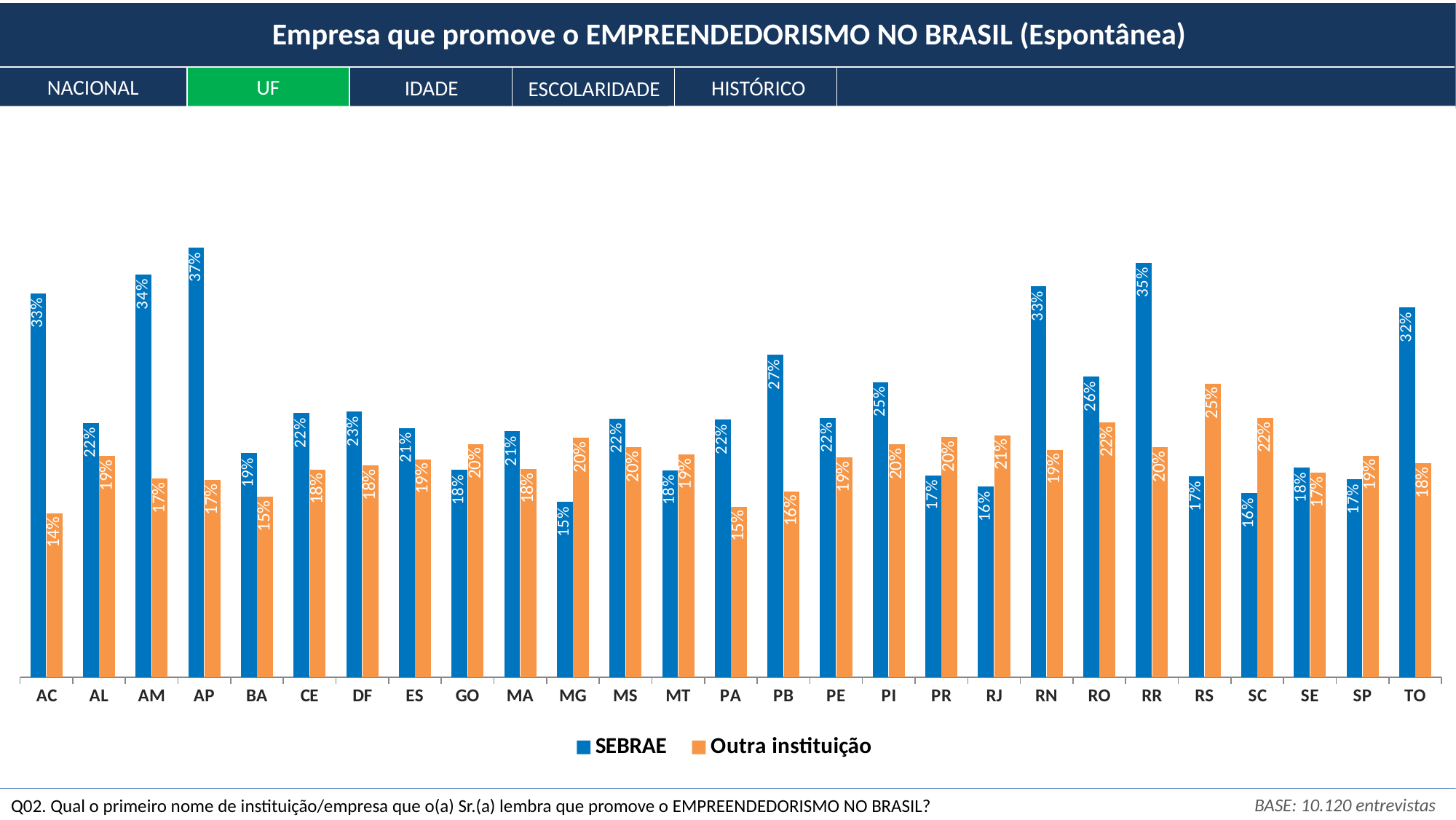
Which state has the highest SEBRAE value? AP What kind of chart is shown on the slide? Bar chart Which state has the lowest Outra instituição value? AC How many series does the legend list? 2 Which colour represents the SEBRAE series? Blue What is the SEBRAE value for RN? 33% How many states are shown on the x axis? 27 For RS, which is larger: SEBRAE or Outra instituição? Outra instituição Which state has the lowest SEBRAE value? MG What is the difference between the SEBRAE and Outra instituição values for AC? 19 percentage points What is the Outra instituição value for RS? 25% What is the SEBRAE value for AP? 37%